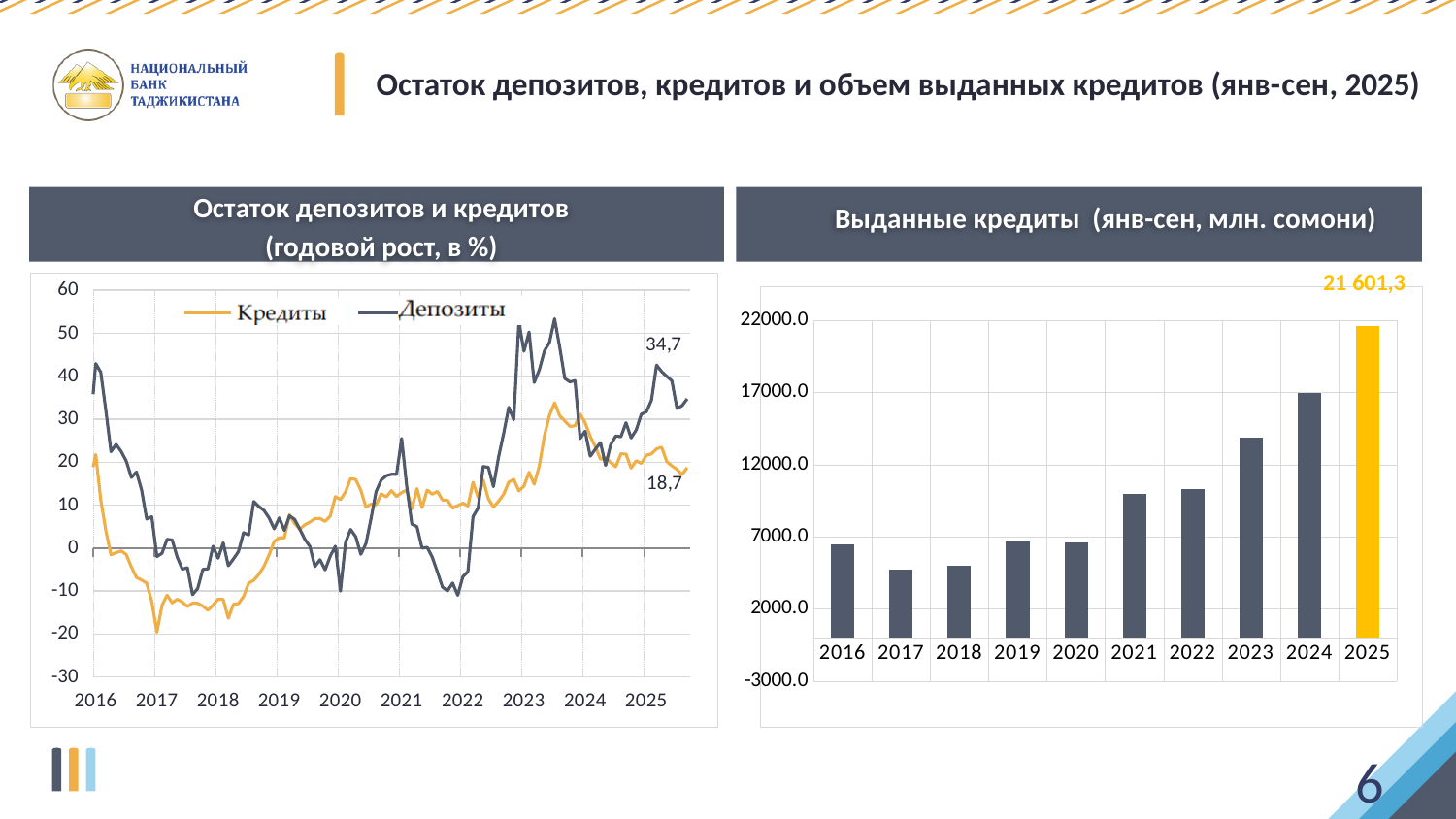
In the chart 'Остаток депозитов и кредитов (годовой рост, в %)', what is the latest labelled value for Кредиты? 18,7 In the chart 'Выданные кредиты (янв-сен, млн. сомони)', how many years (bars) are shown? 10 In the chart 'Выданные кредиты (янв-сен, млн. сомони)', what is the value for 2025? 21 601,3 In the chart 'Остаток депозитов и кредитов (годовой рост, в %)', what is the difference between the latest labelled values for Депозиты (34,7) and Кредиты (18,7)? 16,0 In the chart 'Выданные кредиты (янв-сен, млн. сомони)', do the values generally rise or fall from 2016 to 2025? rise In the chart 'Выданные кредиты (янв-сен, млн. сомони)', is the value for 2016 greater or less than 7000? less What kind of chart is 'Выданные кредиты (янв-сен, млн. сомони)'? bar chart In the chart 'Остаток депозитов и кредитов (годовой рост, в %)', how many series does the legend list? 2 In the chart 'Остаток депозитов и кредитов (годовой рост, в %)', what is the latest labelled value for Депозиты? 34,7 In the chart 'Выданные кредиты (янв-сен, млн. сомони)', which year has the highest value? 2025 In the chart 'Выданные кредиты (янв-сен, млн. сомони)', is the value for 2021 greater or less than 7000? greater In the chart 'Выданные кредиты (янв-сен, млн. сомони)', which is larger, the value for 2019 or the value for 2021? 2021